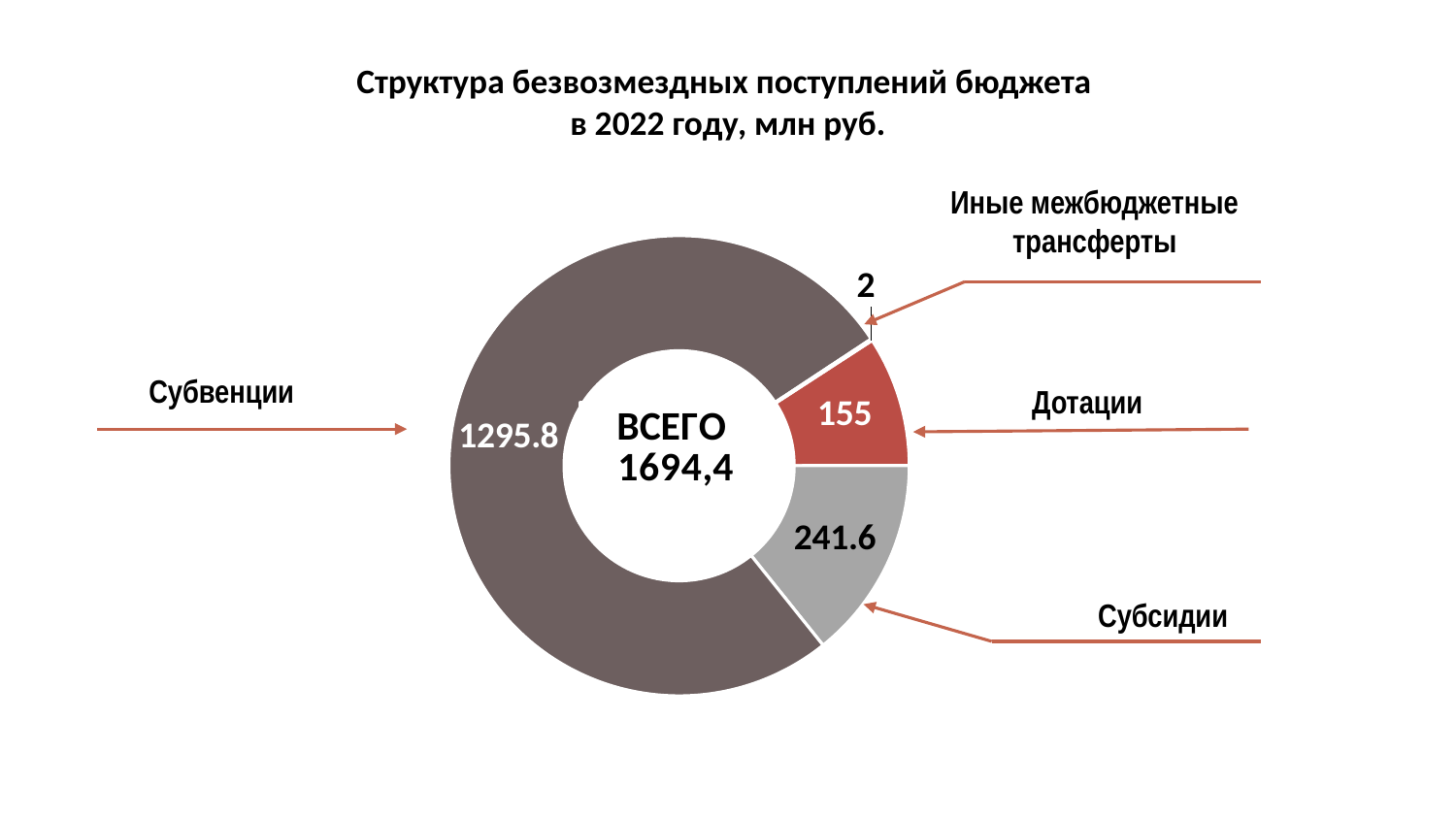
Which is larger, the value for Дотации or the value for Субсидии? Субсидии What is the value for Иные межбюджетные трансферты? 2 What total is shown in the centre of the chart? 1694,4 What is the value for Субвенции? 1295.8 What is the difference between the values for Субвенции and Субсидии? 1054.2 What is the difference between the values for Субсидии and Дотации? 86.6 What is the value for Дотации? 155 Which category has the largest value? Субвенции What kind of chart is shown on the slide? Donut (pie) chart How many categories does the chart show? 4 What is the value for Субсидии? 241.6 Which category has the smallest value? Иные межбюджетные трансферты